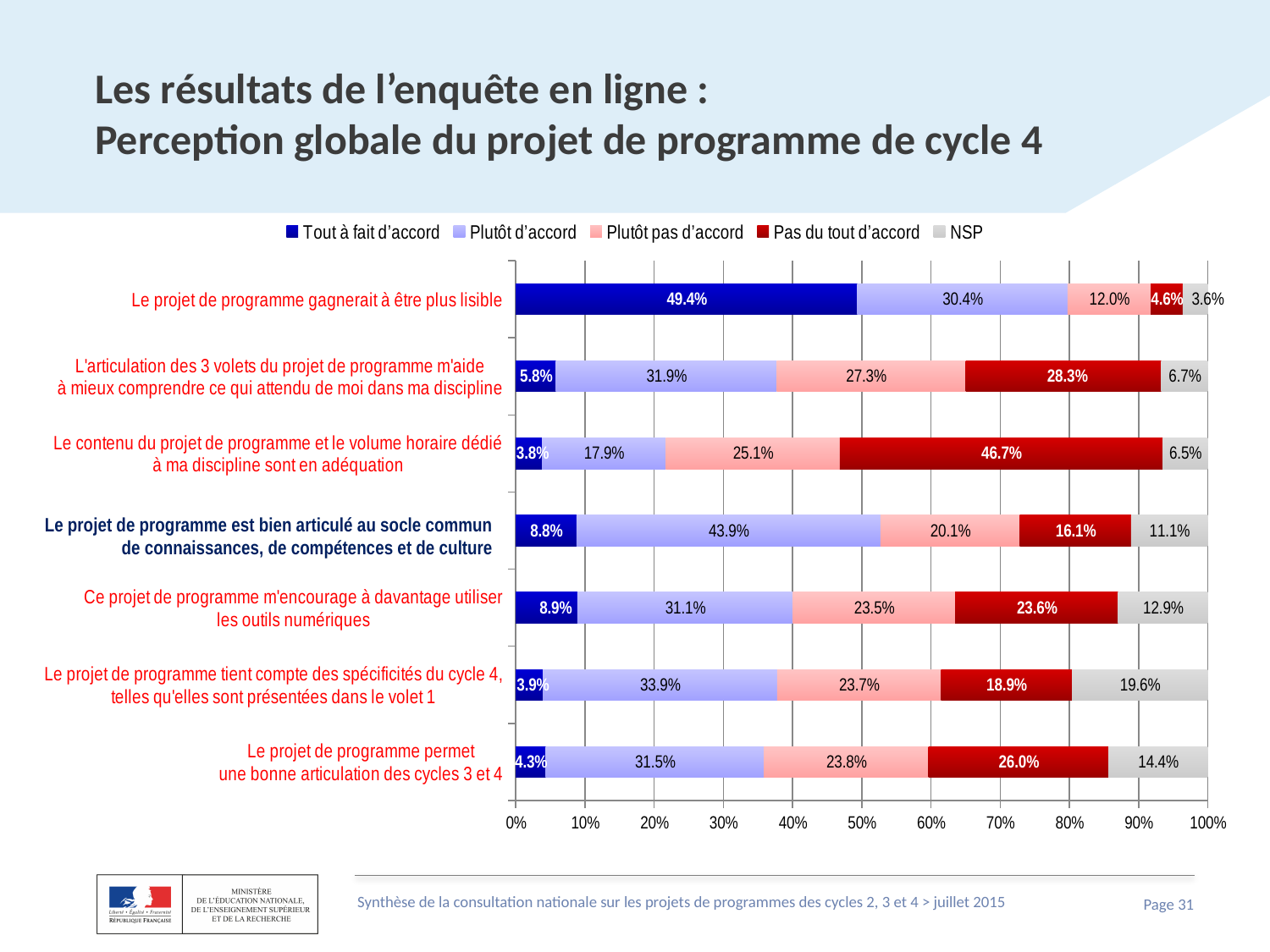
What is the difference between the 'Plutôt pas d'accord' value for 'L'articulation des 3 volets du projet de programme m'aide à mieux comprendre ce qui attendu de moi dans ma discipline' and that for 'Le projet de programme gagnerait à être plus lisible'? 15.3% Which statement has the highest 'Pas du tout d'accord' value? Le contenu du projet de programme et le volume horaire dédié à ma discipline sont en adéquation What is the 'Tout à fait d'accord' value for 'Le projet de programme gagnerait à être plus lisible'? 49.4% What is the 'Plutôt d'accord' value for 'Le projet de programme est bien articulé au socle commun de connaissances, de compétences et de culture'? 43.9% How many statements (categories) are plotted in the chart? 7 Which is larger: the 'Pas du tout d'accord' value for 'Le projet de programme permet une bonne articulation des cycles 3 et 4' or for 'Ce projet de programme m'encourage à davantage utiliser les outils numériques'? Le projet de programme permet une bonne articulation des cycles 3 et 4 Which legend entry is shown in dark red? Pas du tout d'accord What is the 'NSP' value for 'Le projet de programme tient compte des spécificités du cycle 4, telles qu'elles sont présentées dans le volet 1'? 19.6% What kind of chart is shown on the slide? Stacked bar chart Which statement has the lowest 'NSP' value? Le projet de programme gagnerait à être plus lisible What is the 'Pas du tout d'accord' value for 'Le contenu du projet de programme et le volume horaire dédié à ma discipline sont en adéquation'? 46.7% How many series does the legend list? 5